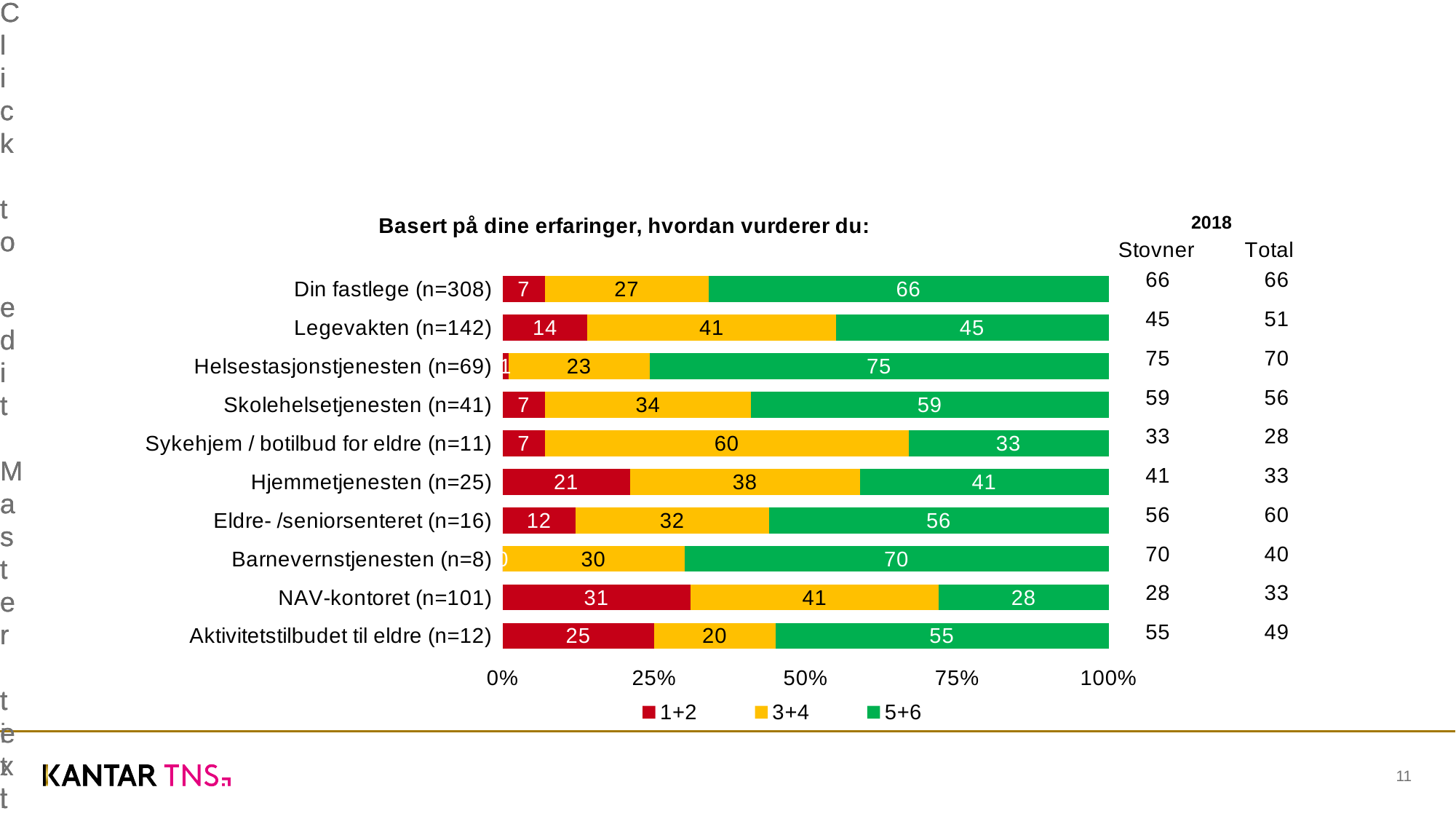
What is the title of the chart? Basert på dine erfaringer, hvordan vurderer du: What is the value of the 1+2 series for NAV-kontoret (n=101)? 31 How many series does the legend list? 3 Which has the larger 1+2 value: NAV-kontoret (n=101) or Aktivitetstilbudet til eldre (n=12)? NAV-kontoret (n=101) Which category has the highest value for the 1+2 series? NAV-kontoret (n=101) What kind of chart is shown on the slide? Stacked bar chart Which category has the lowest value for the 5+6 series? NAV-kontoret (n=101) Which category has the highest value for the 5+6 series? Helsestasjonstjenesten (n=69) What is the value of the 3+4 series for Sykehjem / botilbud for eldre (n=11)? 60 What is the value of the 5+6 series for Din fastlege (n=308)? 66 How many categories are shown in the chart? 10 What is the difference between the 5+6 values for Din fastlege (n=308) and Legevakten (n=142)? 21